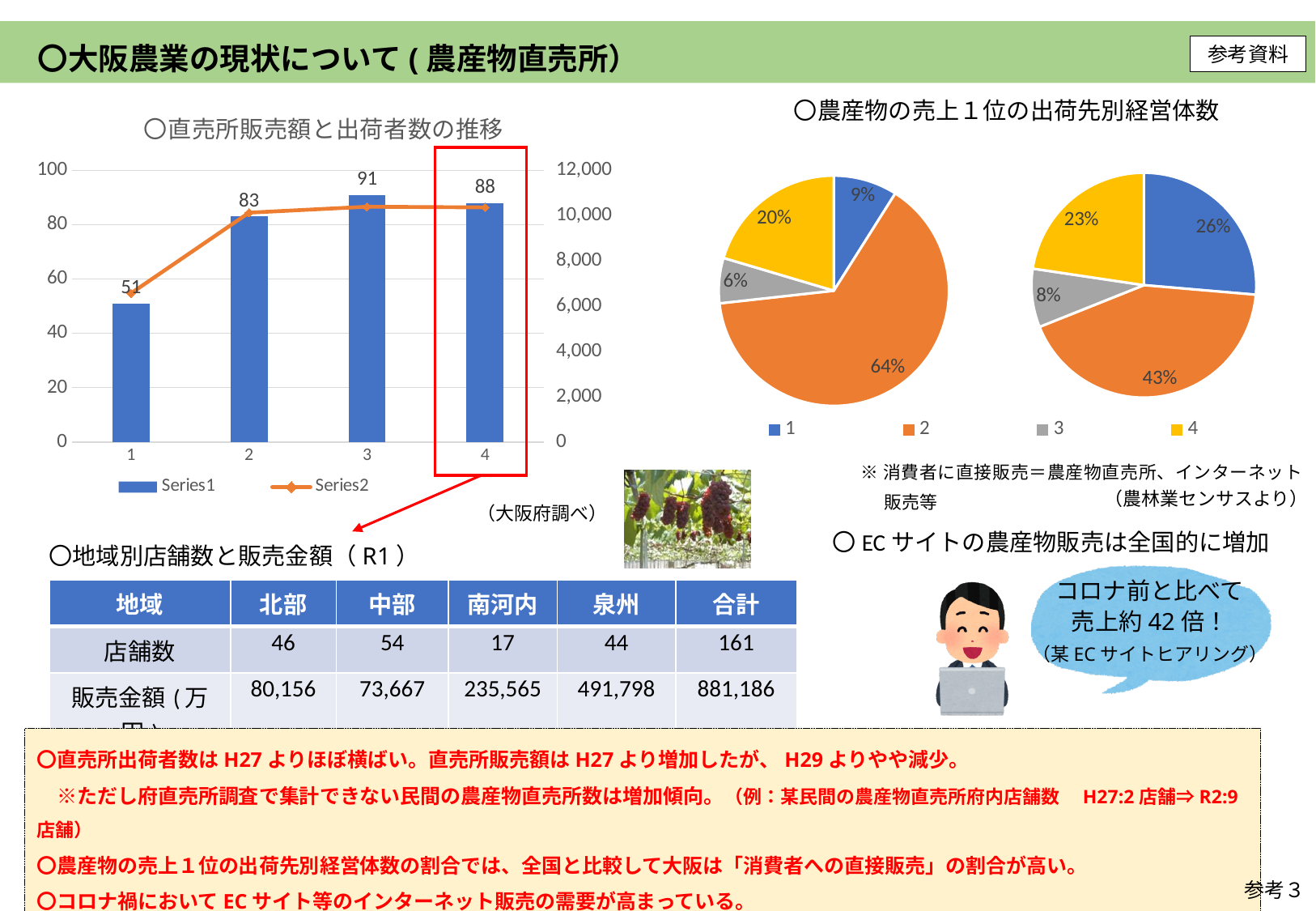
In the chart titled 直売所販売額と出荷者数の推移, what is the difference between the Series1 values for category 2 and category 1? 32 In the right pie chart under 農産物の売上1位の出荷先別経営体数, which slice is the smallest? 3 In the chart titled 直売所販売額と出荷者数の推移, what is the Series1 value for category 3? 91 In the right pie chart under 農産物の売上1位の出荷先別経営体数, what share does slice 1 have? 26% In the left pie chart under 農産物の売上1位の出荷先別経営体数, what share does slice 2 have? 64% In the chart titled 直売所販売額と出荷者数の推移, which category has the highest Series1 value? 3 In the chart titled 直売所販売額と出荷者数の推移, how many series does the legend list? 2 In the chart titled 直売所販売額と出荷者数の推移, how many categories are shown on the x axis? 4 Which is larger: slice 4 in the left pie chart or slice 4 in the right pie chart? right pie chart (23%) In the chart titled 直売所販売額と出荷者数の推移, which category has the lowest Series1 value? 1 In the chart titled 直売所販売額と出荷者数の推移, is the Series2 value for category 1 greater or less than 8,000? less In the chart titled 直売所販売額と出荷者数の推移, what is the Series1 value for category 1? 51